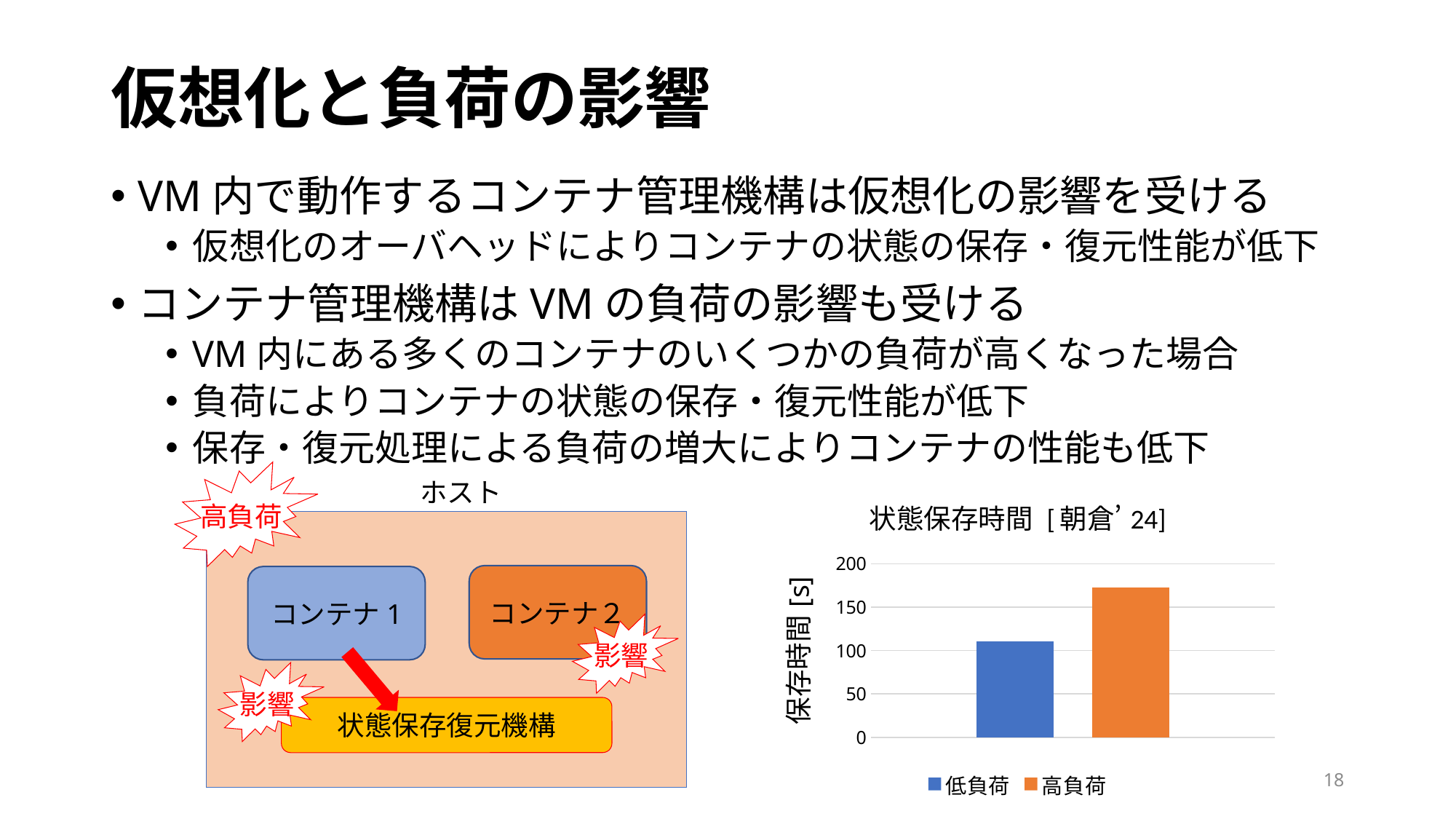
Is the bar for 高負荷 taller or shorter than the bar for 低負荷? taller How many series does the legend of the chart list? 2 What is the label of the vertical axis of the chart? 保存時間 [s] Is the value for 低負荷 greater or less than 100? greater Is the value for 高負荷 greater or less than 150? greater Is the value for 低負荷 greater or less than 150? less What kind of chart is shown on the slide? bar chart Which series has the lower bar in the chart? 低負荷 Which series has the higher bar in the chart, 低負荷 or 高負荷? 高負荷 What is the title of the chart? 状態保存時間 [朝倉'24] How many bars are plotted in the chart? 2